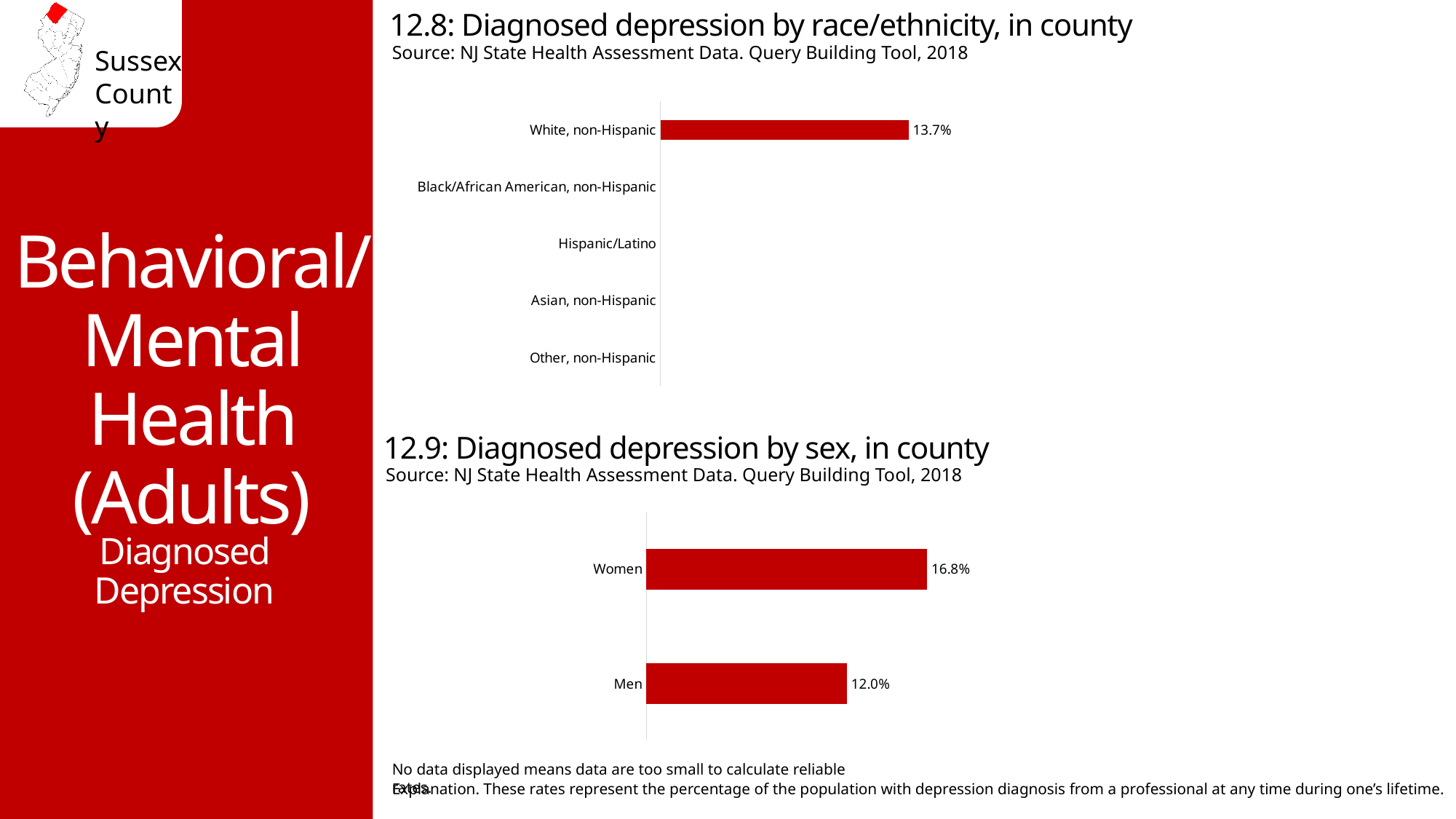
What is the source cited under the chart '12.9: Diagnosed depression by sex, in county'? NJ State Health Assessment Data. Query Building Tool, 2018 In the chart '12.9: Diagnosed depression by sex, in county', which category has the highest value? Women In the chart '12.9: Diagnosed depression by sex, in county', which is larger, the value for Women or the value for Men? Women In the chart '12.8: Diagnosed depression by race/ethnicity, in county', what is the value for White, non-Hispanic? 13.7% In the chart '12.9: Diagnosed depression by sex, in county', what is the value for Women? 16.8% In the chart '12.8: Diagnosed depression by race/ethnicity, in county', which category is the only one with a bar displayed? White, non-Hispanic In the chart '12.9: Diagnosed depression by sex, in county', what is the difference between the values for Women and Men? 4.8 percentage points In the chart '12.9: Diagnosed depression by sex, in county', what is the value for Men? 12.0% What kind of chart is '12.8: Diagnosed depression by race/ethnicity, in county'? Bar chart How many categories are listed on the y axis of the chart '12.8: Diagnosed depression by race/ethnicity, in county'? 5 How many categories are shown in the chart '12.9: Diagnosed depression by sex, in county'? 2 In the chart '12.9: Diagnosed depression by sex, in county', which category has the lowest value? Men